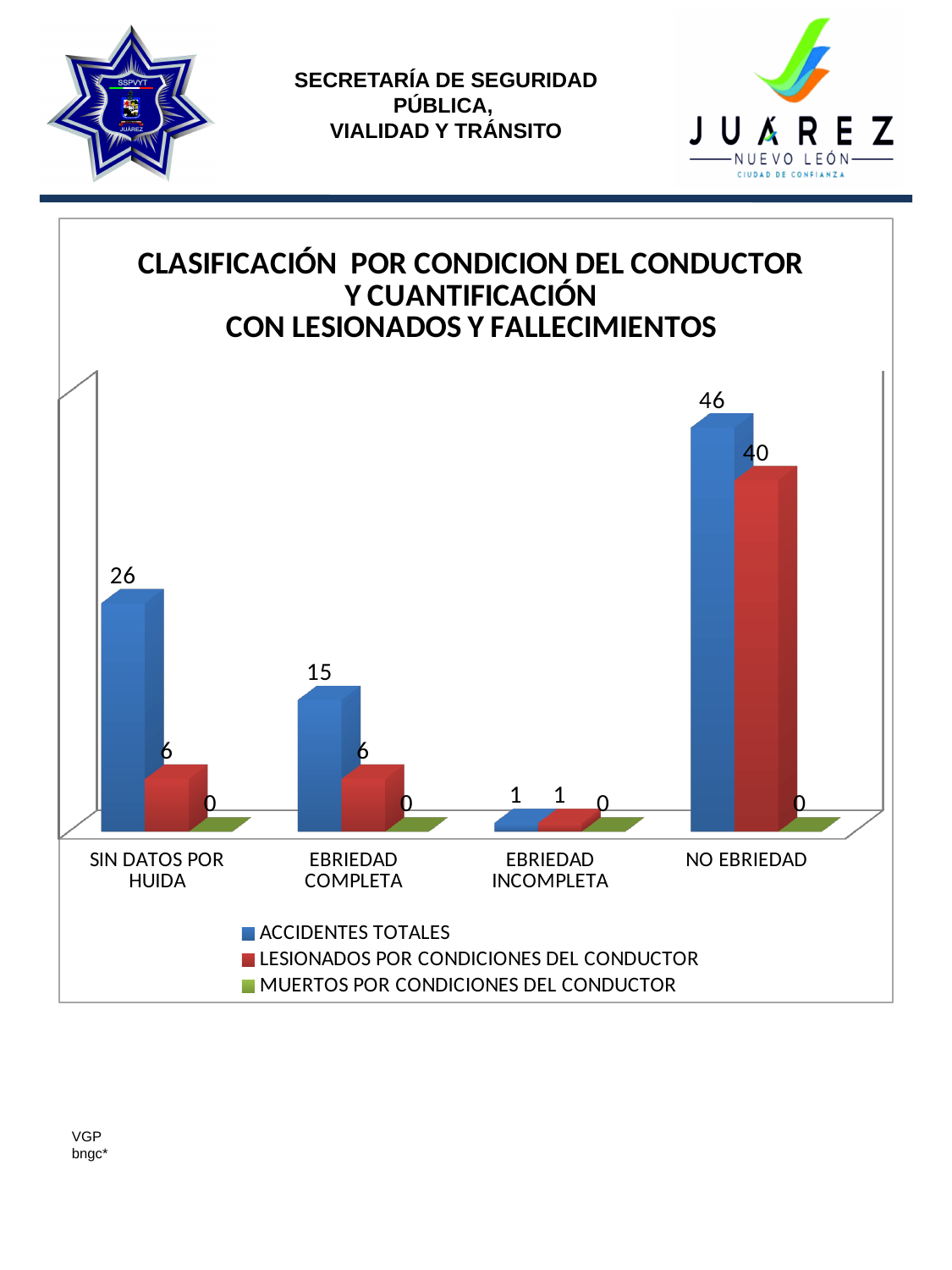
What is the value of ACCIDENTES TOTALES for NO EBRIEDAD? 46 What is the value of MUERTOS POR CONDICIONES DEL CONDUCTOR for NO EBRIEDAD? 0 Which category has the highest value for ACCIDENTES TOTALES? NO EBRIEDAD How many categories are shown on the x axis? 4 How many series does the legend list? 3 What is the difference between ACCIDENTES TOTALES and LESIONADOS POR CONDICIONES DEL CONDUCTOR for NO EBRIEDAD? 6 What is the value of ACCIDENTES TOTALES for EBRIEDAD COMPLETA? 15 What kind of chart is shown on the slide? Bar chart What is the difference in ACCIDENTES TOTALES between SIN DATOS POR HUIDA and EBRIEDAD COMPLETA? 11 Which category has the lowest value for ACCIDENTES TOTALES? EBRIEDAD INCOMPLETA Which is larger: ACCIDENTES TOTALES for SIN DATOS POR HUIDA or for EBRIEDAD COMPLETA? SIN DATOS POR HUIDA What is the value of LESIONADOS POR CONDICIONES DEL CONDUCTOR for SIN DATOS POR HUIDA? 6